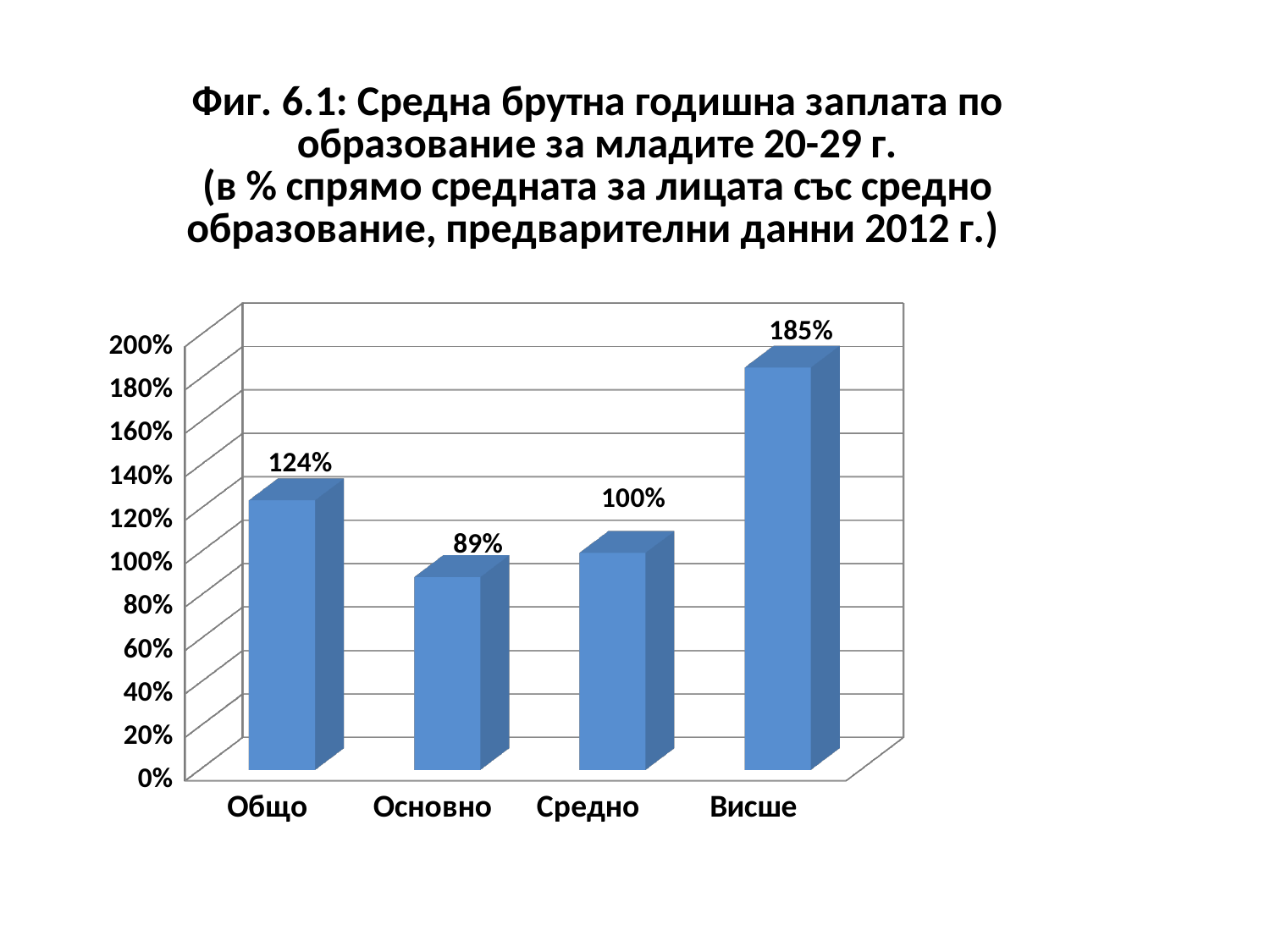
How many categories are shown on the x axis? 4 What is the difference between the values for Висше and Средно? 85% What is the highest tick value shown on the vertical axis? 200% What is the difference between the values for Общо and Основно? 35% What kind of chart is shown on the slide? Bar chart What is the value for Висше? 185% Which is larger, the value for Общо or the value for Средно? Общо What is the value for Основно? 89% Which category has the lowest value? Основно What is the value for Общо? 124% Which category has the highest value? Висше What is the value for Средно? 100%